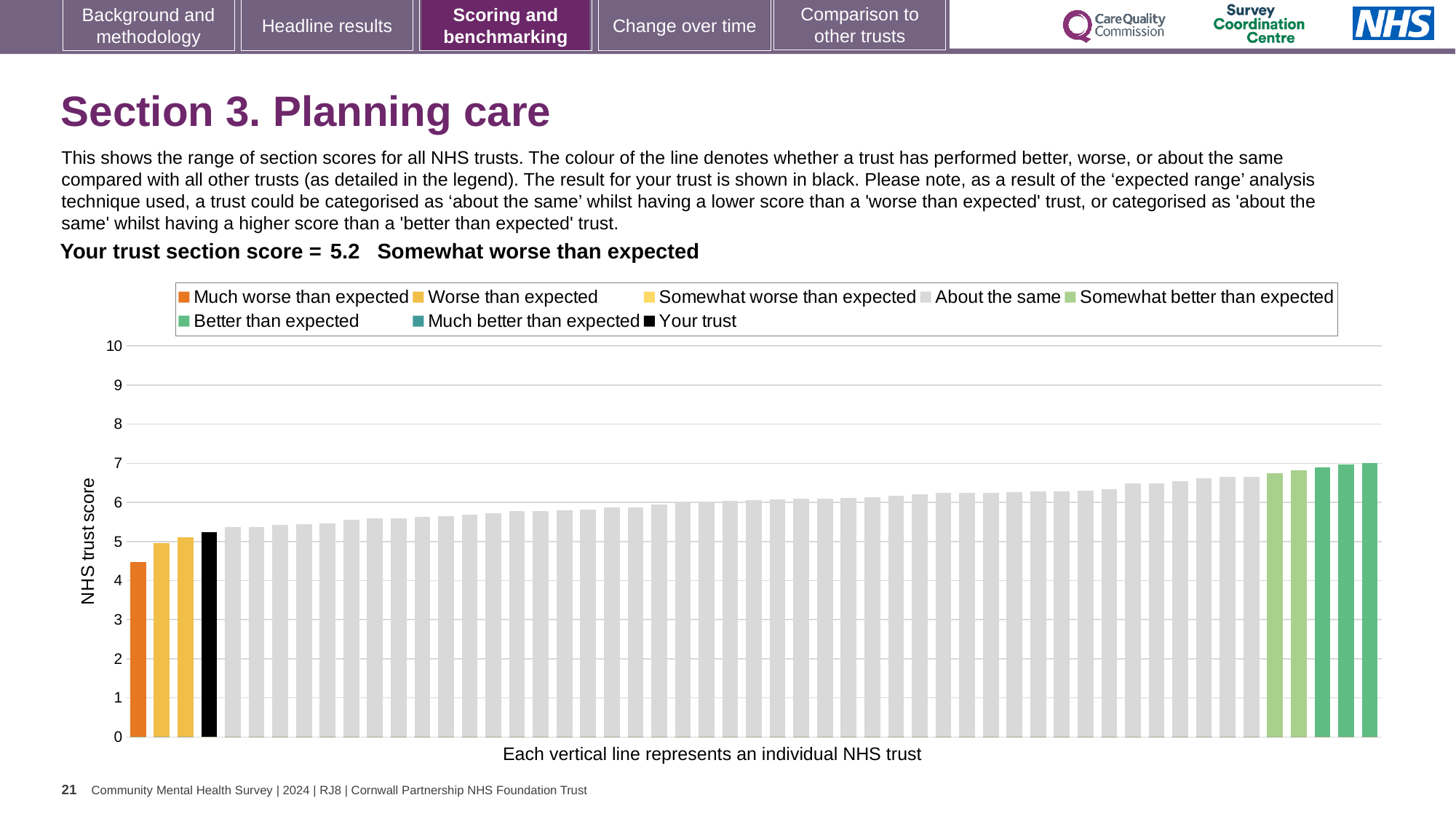
What is the section score for your trust shown on the slide? 5.2 Is the value of the lowest bar (the orange one) greater or less than 5? less What is the label on the vertical axis of the chart? NHS trust score How many entries does the chart legend list? 8 How many bars are coloured dark green ('Better than expected')? 3 Is the value of the tallest bar on the right greater or less than 6? greater Which legend category is your trust's score classified as? Somewhat worse than expected What kind of chart is shown on the slide? bar chart Is the value of the black 'Your trust' bar greater or less than 5? greater How many bars are coloured orange ('Much worse than expected')? 1 Do the bar values rise or fall from left to right along the x axis? rise